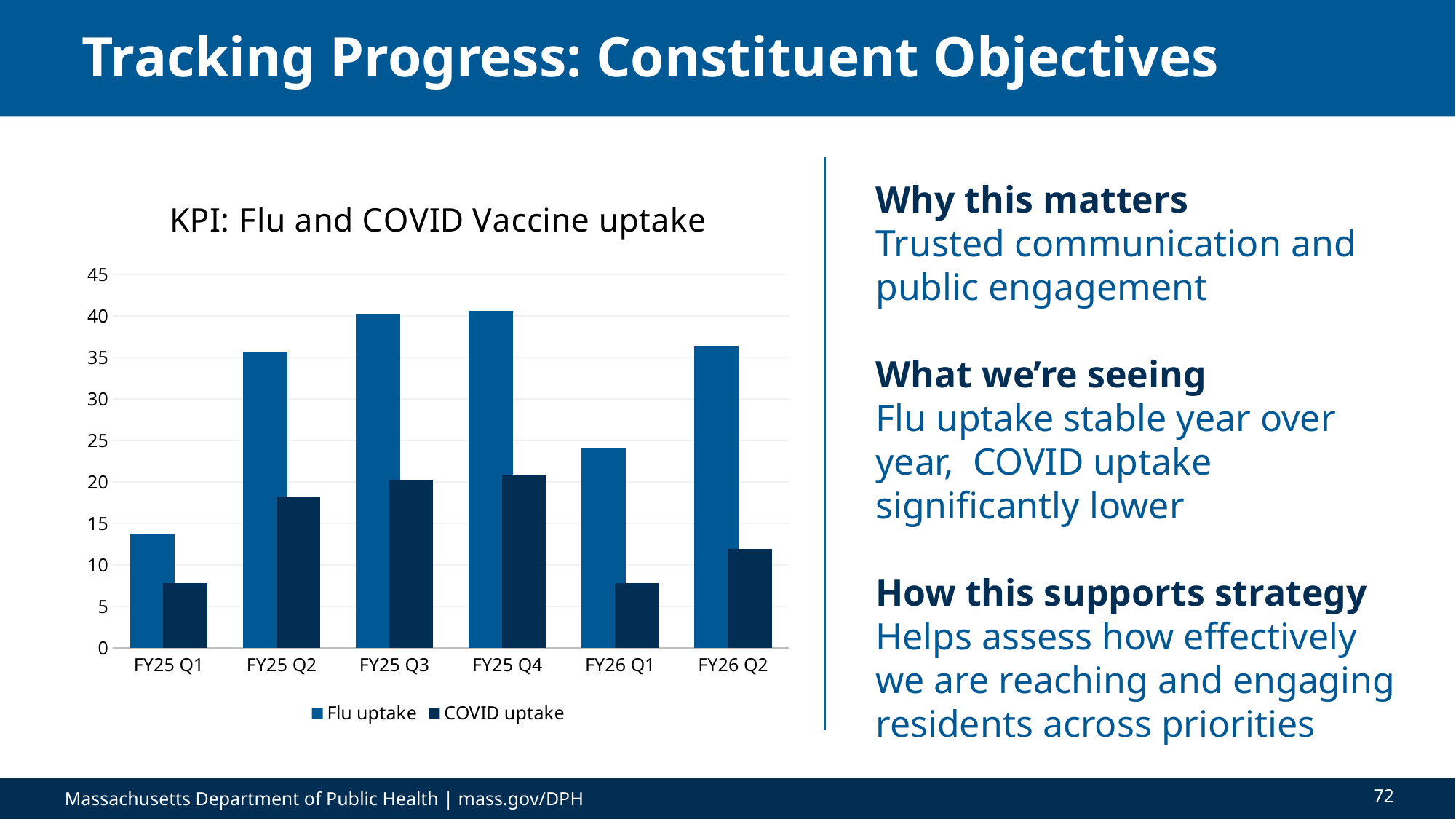
Does Flu uptake rise or fall from FY25 Q1 to FY25 Q4? rise Which is larger, COVID uptake in FY25 Q3 or COVID uptake in FY26 Q2? FY25 Q3 Which quarter has the lowest Flu uptake? FY25 Q1 Is the Flu uptake value for FY25 Q1 greater or less than 15? less How many series does the legend list? 2 Is the COVID uptake value for FY26 Q2 greater or less than 10? greater What is the title of the chart? KPI: Flu and COVID Vaccine uptake What kind of chart is shown on the slide? bar chart How many quarters are shown on the x axis? 6 Which is larger, Flu uptake in FY25 Q2 or Flu uptake in FY26 Q1? FY25 Q2 Is the Flu uptake value for FY25 Q3 greater or less than 35? greater